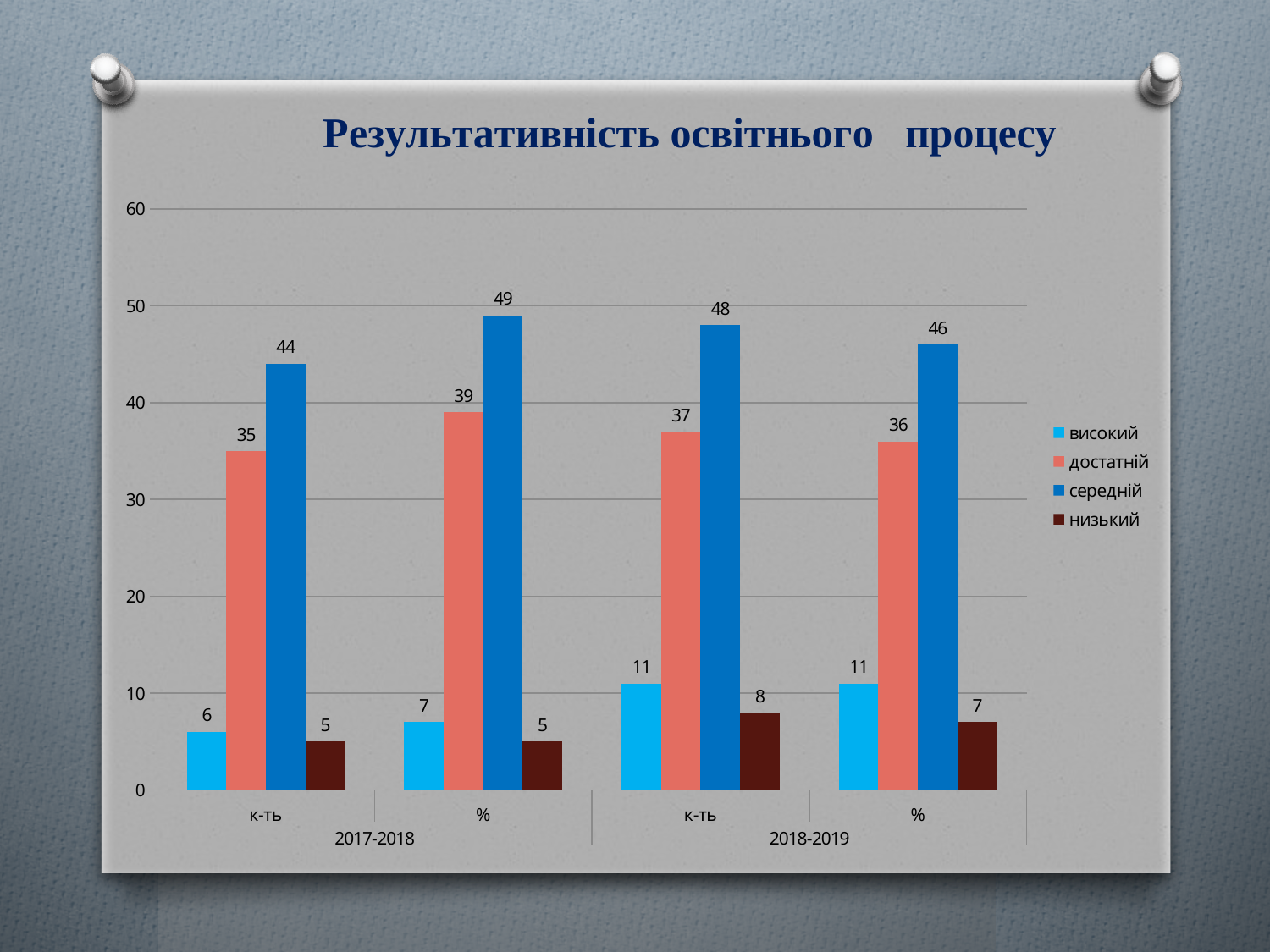
What is the title of the chart? Результативність освітнього процесу What is the value of середній for к-ть in 2017-2018? 44 How many series does the legend list? 4 What is the value of достатній for % in 2018-2019? 36 Which series has the highest value for % in 2017-2018? середній How many category groups are shown along the x axis? 4 What is the difference between the середній values for % in 2017-2018 and % in 2018-2019? 3 What type of chart is shown on the slide? bar chart Which series has the lowest value for к-ть in 2018-2019? низький Which is larger: достатній for к-ть in 2017-2018 or достатній for к-ть in 2018-2019? достатній for к-ть in 2018-2019 What is the value of низький for % in 2017-2018? 5 What is the value of високий for к-ть in 2018-2019? 11